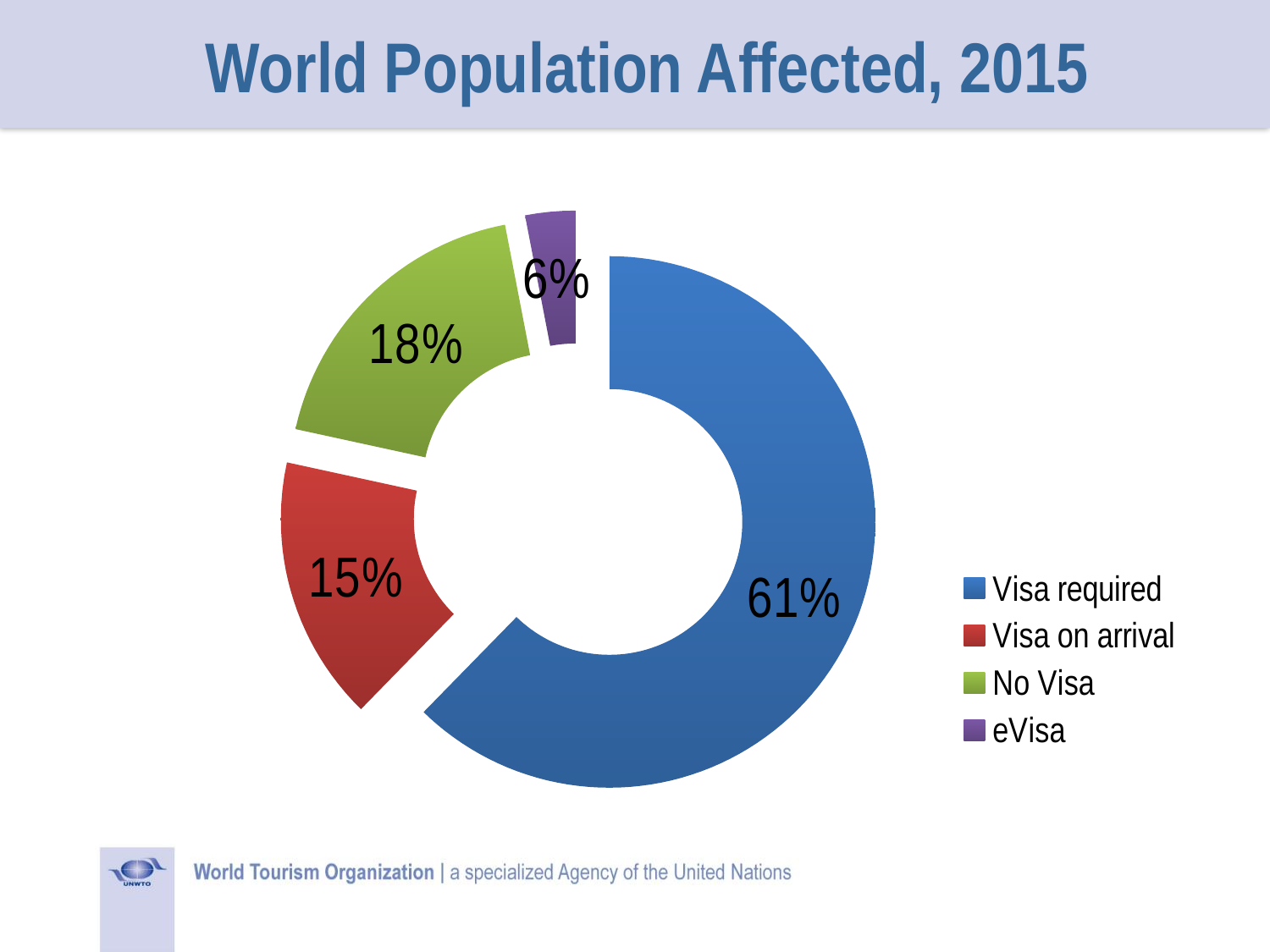
Which category has the smallest share of the chart? eVisa Which category has the largest share of the chart? Visa required What is the difference in percentage points between Visa required and No Visa? 43 What share of the world population is shown for eVisa? 6% What share of the world population is shown for No Visa? 18% Which is larger, the share for Visa on arrival or the share for eVisa? Visa on arrival What kind of chart is shown on the slide? Doughnut (pie) chart What share of the world population is shown for Visa on arrival? 15% How many categories does the chart show? 4 What is the title of the slide? World Population Affected, 2015 What share of the world population is shown for Visa required? 61% What is the difference in percentage points between No Visa and Visa on arrival? 3